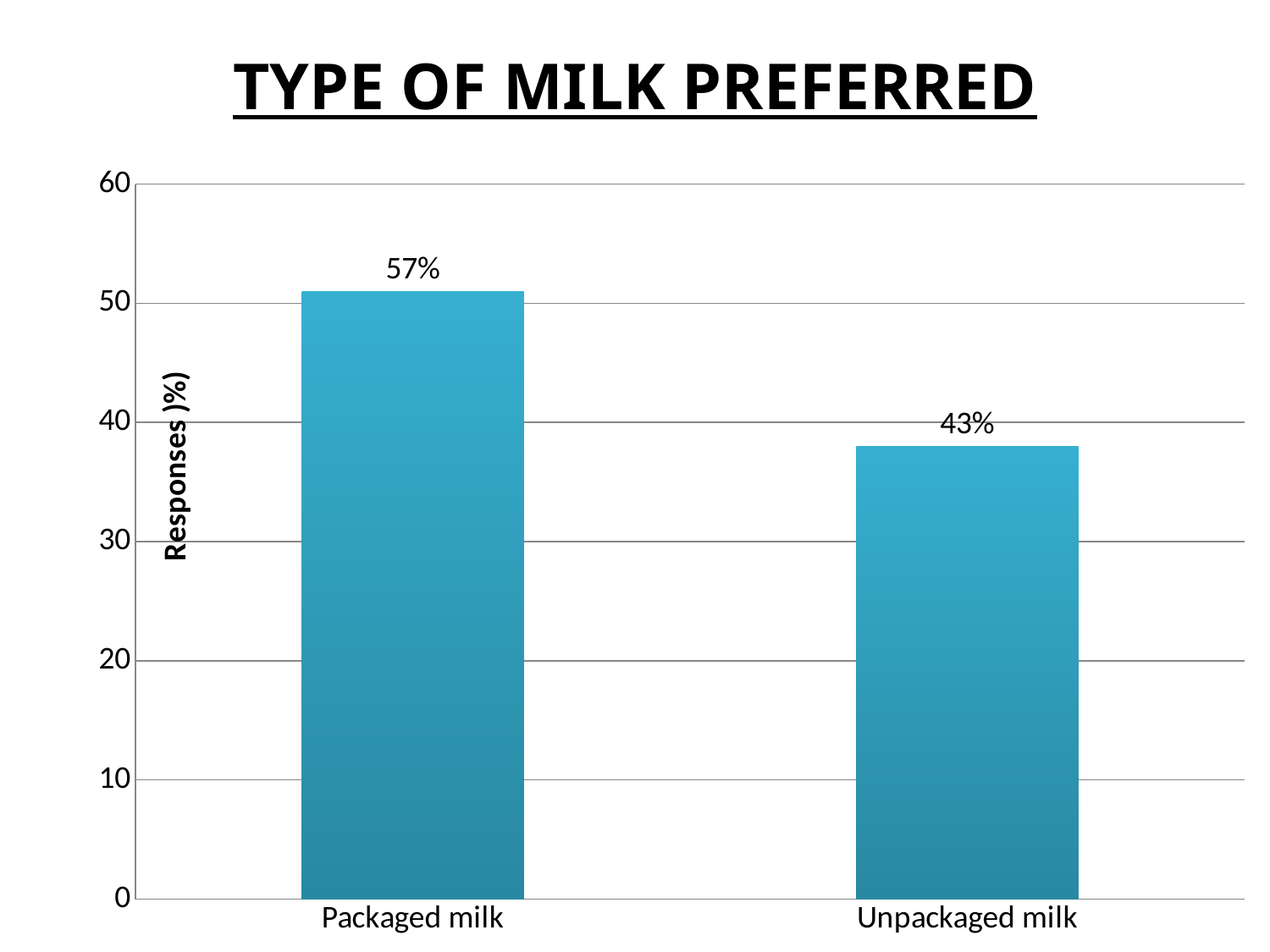
Is the value for Unpackaged milk greater or less than 30? greater What is the title of the slide? TYPE OF MILK PREFERRED What kind of chart is shown on the slide? bar chart Which type of milk has the highest value? Packaged milk Is the value for Unpackaged milk greater or less than 50? less Which is larger, the value for Packaged milk or the value for Unpackaged milk? Packaged milk Is the value for Packaged milk greater or less than 50? greater What is the value for Packaged milk? 57% What is the difference between the values for Packaged milk and Unpackaged milk? 14% What is the value for Unpackaged milk? 43% How many categories are shown on the chart? 2 Which type of milk has the lowest value? Unpackaged milk